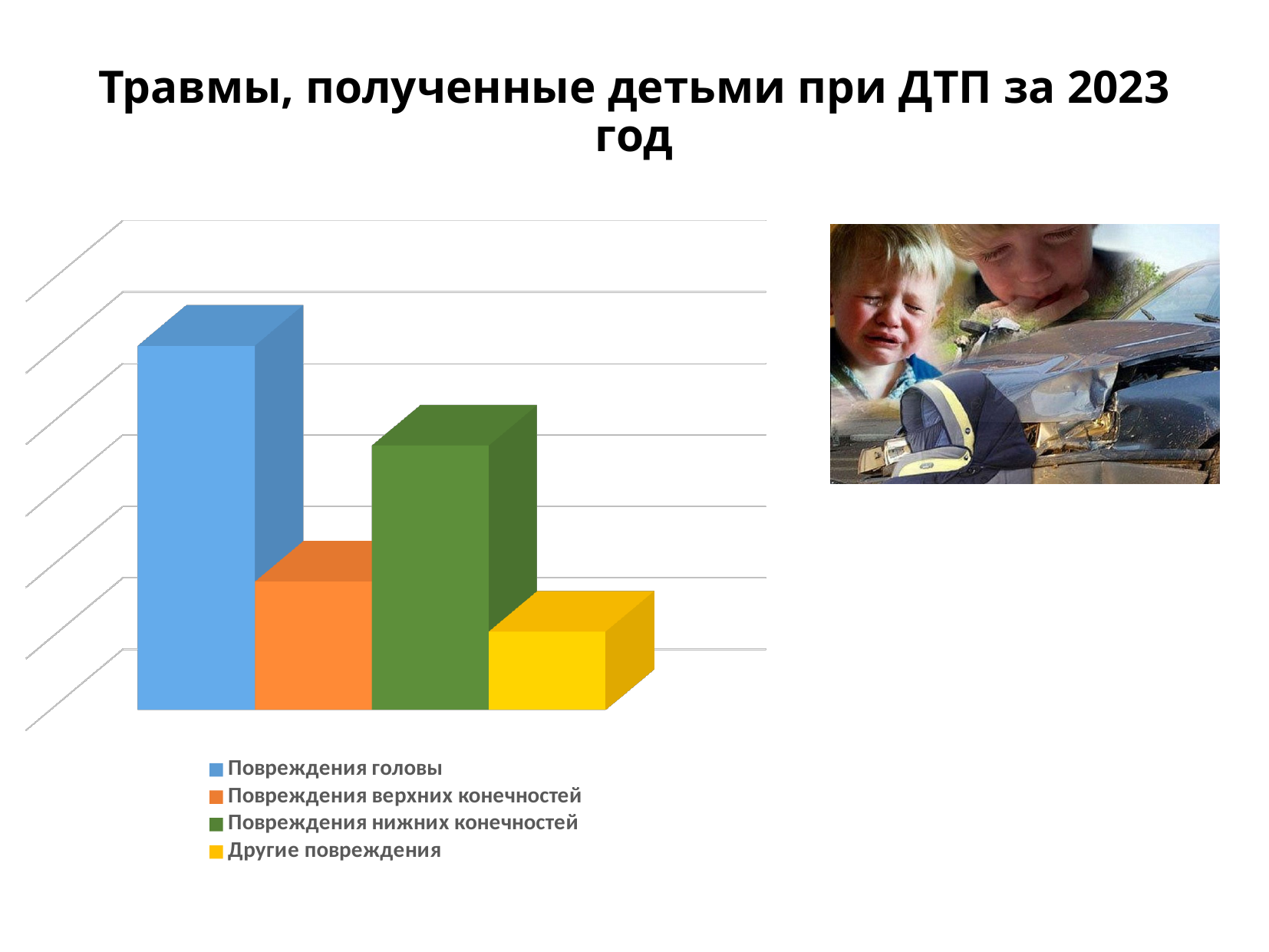
Which category has the second-highest bar in the chart? Повреждения нижних конечностей Which is larger: the bar for Повреждения головы or the bar for Повреждения нижних конечностей? Повреждения головы How many bars are plotted in the chart? 4 Which is larger: the bar for Повреждения верхних конечностей or the bar for Повреждения нижних конечностей? Повреждения нижних конечностей Which is larger: the bar for Повреждения верхних конечностей or the bar for Другие повреждения? Повреждения верхних конечностей What kind of chart is shown on the slide? bar chart What colour is the bar for Повреждения нижних конечностей? green What is the title of the slide containing the chart? Травмы, полученные детьми при ДТП за 2023 год How many entries does the chart legend list? 4 Which category has the highest bar in the chart? Повреждения головы Which category has the lowest bar in the chart? Другие повреждения